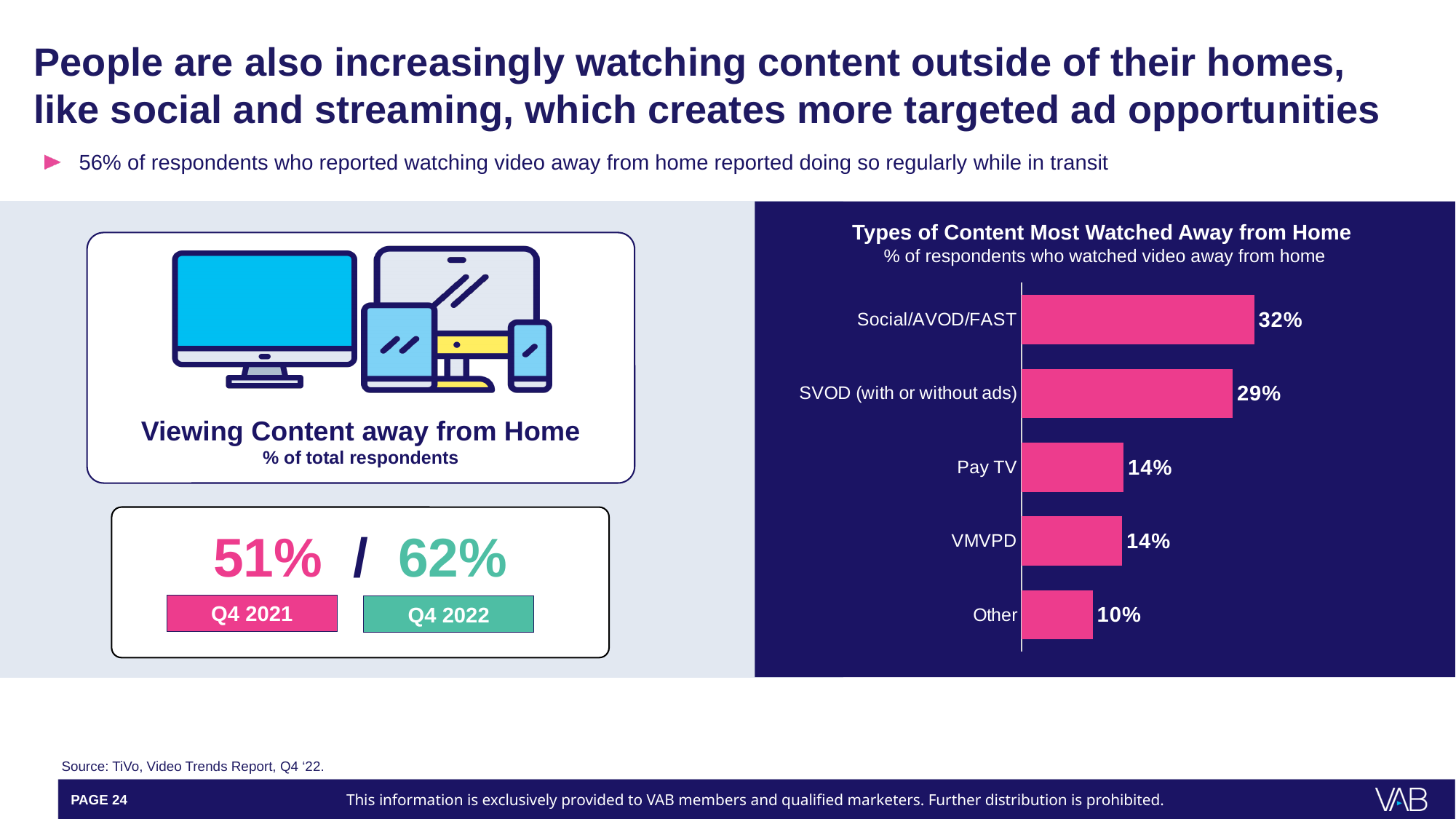
In the 'Types of Content Most Watched Away from Home' chart, what is the difference between Pay TV and Other? 4% In the 'Types of Content Most Watched Away from Home' chart, what is the value for Pay TV? 14% How many categories are shown in the 'Types of Content Most Watched Away from Home' chart? 5 In the 'Types of Content Most Watched Away from Home' chart, what is the difference between Social/AVOD/FAST and SVOD (with or without ads)? 3% In the 'Types of Content Most Watched Away from Home' chart, what is the value for Other? 10% In the 'Types of Content Most Watched Away from Home' chart, which is larger: SVOD (with or without ads) or Pay TV? SVOD (with or without ads) In the 'Types of Content Most Watched Away from Home' chart, which category has the lowest value? Other In the 'Types of Content Most Watched Away from Home' chart, which category has the highest value? Social/AVOD/FAST In the 'Types of Content Most Watched Away from Home' chart, what is the value for SVOD (with or without ads)? 29% In the 'Types of Content Most Watched Away from Home' chart, what is the value for Social/AVOD/FAST? 32% What kind of chart is 'Types of Content Most Watched Away from Home'? Bar chart What is the subtitle shown under the title of the 'Types of Content Most Watched Away from Home' chart? % of respondents who watched video away from home